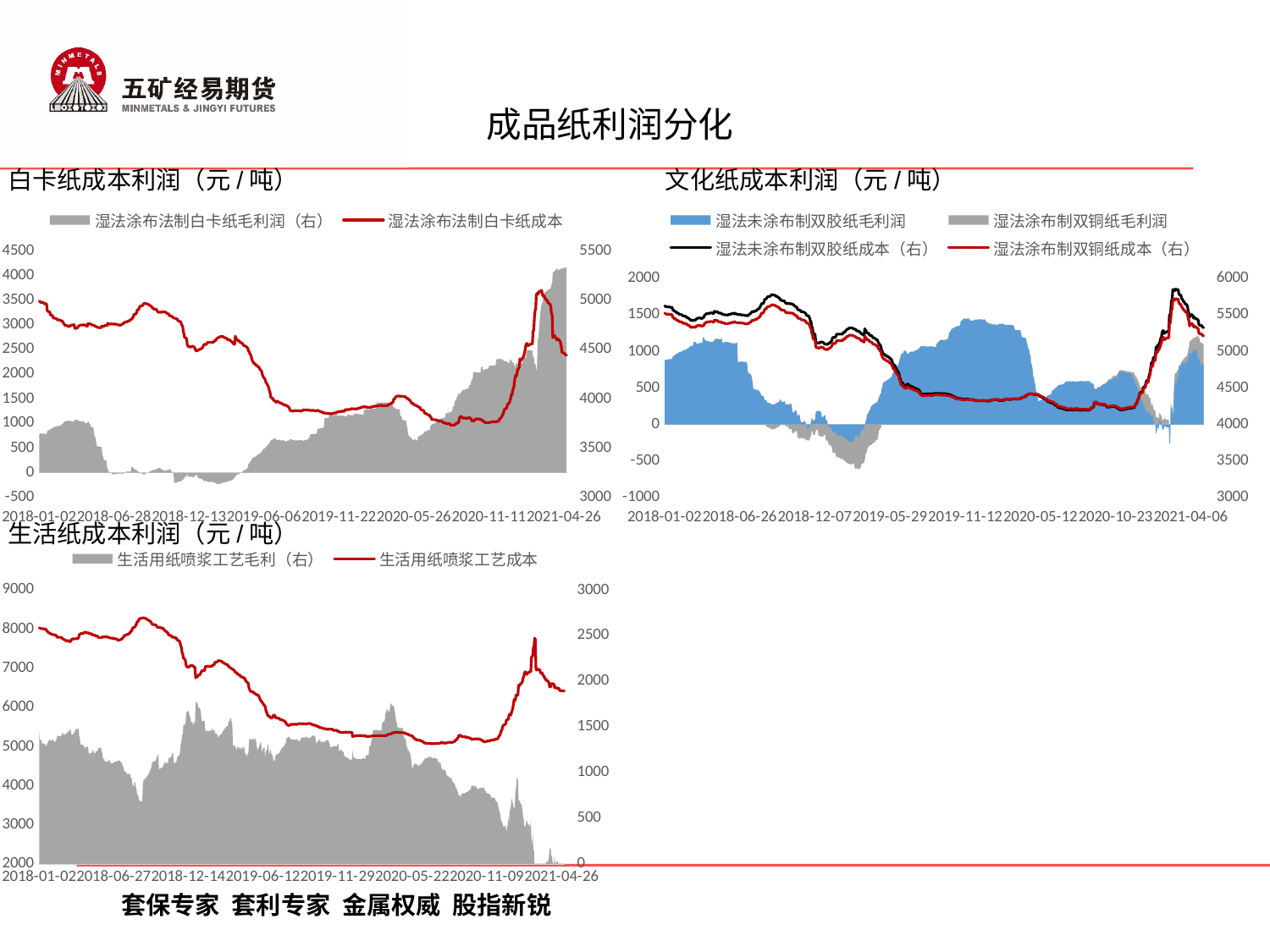
In the 白卡纸成本利润（元/吨） chart, is the value of 湿法涂布法制白卡纸成本 at the start of the period (2018-01-02) greater or less than 3000? greater In the 白卡纸成本利润（元/吨） chart, how many series does the legend list? 2 In the 文化纸成本利润（元/吨） chart, how many series does the legend list? 4 In the 生活纸成本利润（元/吨） chart, is the value of 生活用纸喷浆工艺成本 at the end of the period higher or lower than at the start? lower In the 生活纸成本利润（元/吨） chart, is the value of 生活用纸喷浆工艺毛利（右） at the end of the period greater or less than 500 on the right axis? less How many charts are on the slide? 3 In the 生活纸成本利润（元/吨） chart, how many series does the legend list? 2 In the 文化纸成本利润（元/吨） chart, is the peak value of 湿法未涂布制双胶纸毛利润 around mid-2020 greater or less than 1000? greater In the 文化纸成本利润（元/吨） chart, what colour is the 湿法未涂布制双胶纸毛利润 series? blue In the 白卡纸成本利润（元/吨） chart, what kind of chart is used for the 湿法涂布法制白卡纸成本 series? line chart